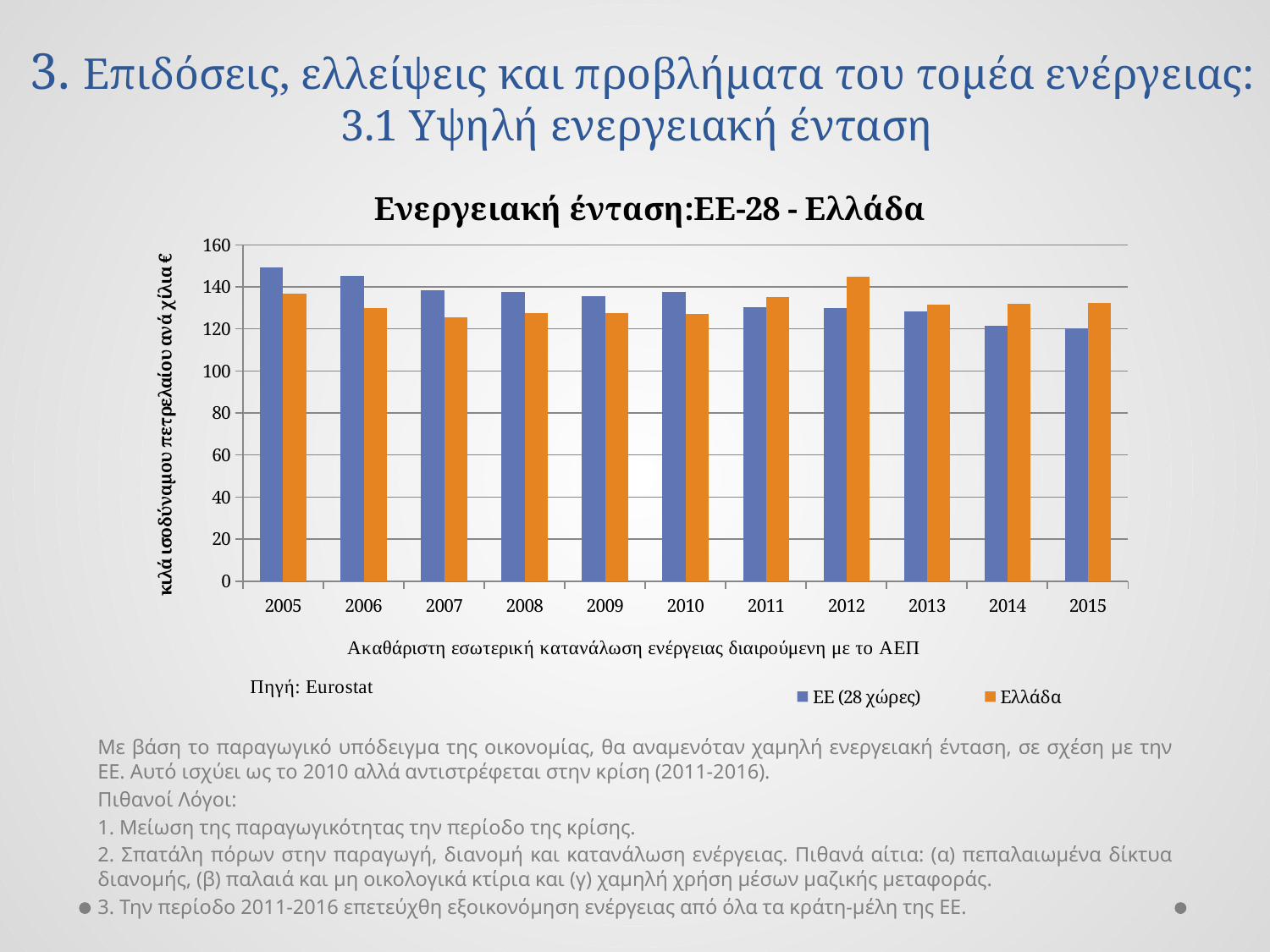
How many series does the legend list? 2 In 2005, which is larger: ΕΕ (28 χώρες) or Ελλάδα? ΕΕ (28 χώρες) How many years are shown on the x axis? 11 Does the value for ΕΕ (28 χώρες) generally rise or fall from 2005 to 2015? Fall Is the value for Ελλάδα in 2007 greater or less than 140? less In which year is the value for ΕΕ (28 χώρες) highest? 2005 What is the title of the chart? Ενεργειακή ένταση:ΕΕ-28 - Ελλάδα What kind of chart is shown on the slide? Bar chart Is the value for ΕΕ (28 χώρες) in 2005 greater or less than 140? greater In 2012, which is larger: ΕΕ (28 χώρες) or Ελλάδα? Ελλάδα In which year is the value for Ελλάδα highest? 2012 Is the value for ΕΕ (28 χώρες) in 2015 greater or less than 100? greater